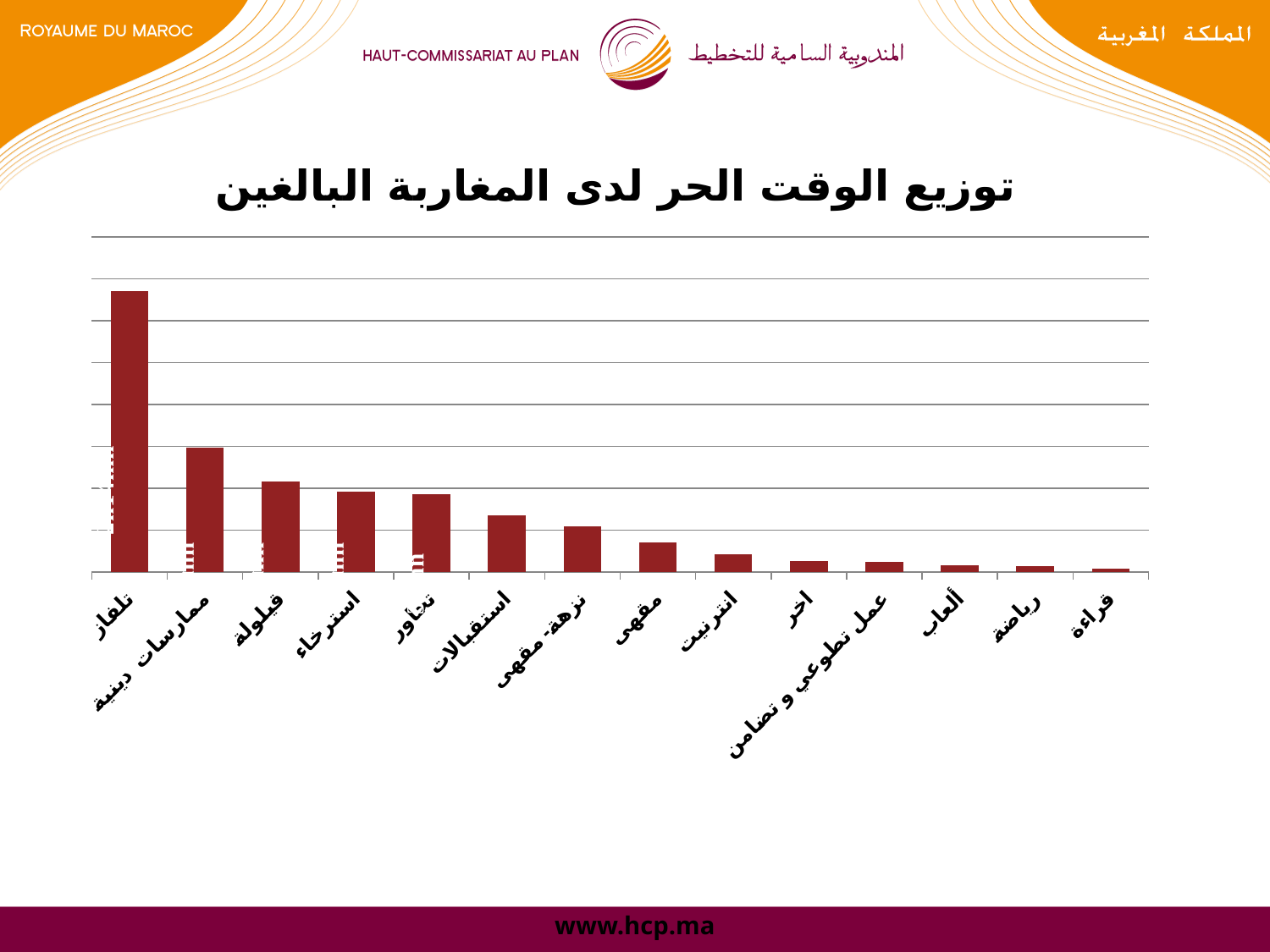
Which is larger, the value for ممارسات دينية or the value for قيلولة? ممارسات دينية Which is larger, the value for تلفاز or the value for ممارسات دينية? تلفاز Which is larger, the value for مقهى or the value for انترنيت? مقهى How many categories are plotted in the chart? 14 Do the values rise or fall moving from left to right along the x axis? fall Which category has the highest value? تلفاز Which category has the lowest value? قراءة What kind of chart is shown on the slide? bar chart What colour are the bars in the chart? dark red What is the title of the chart? توزيع الوقت الحر لدى المغاربة البالغين Which category has the second highest value? ممارسات دينية